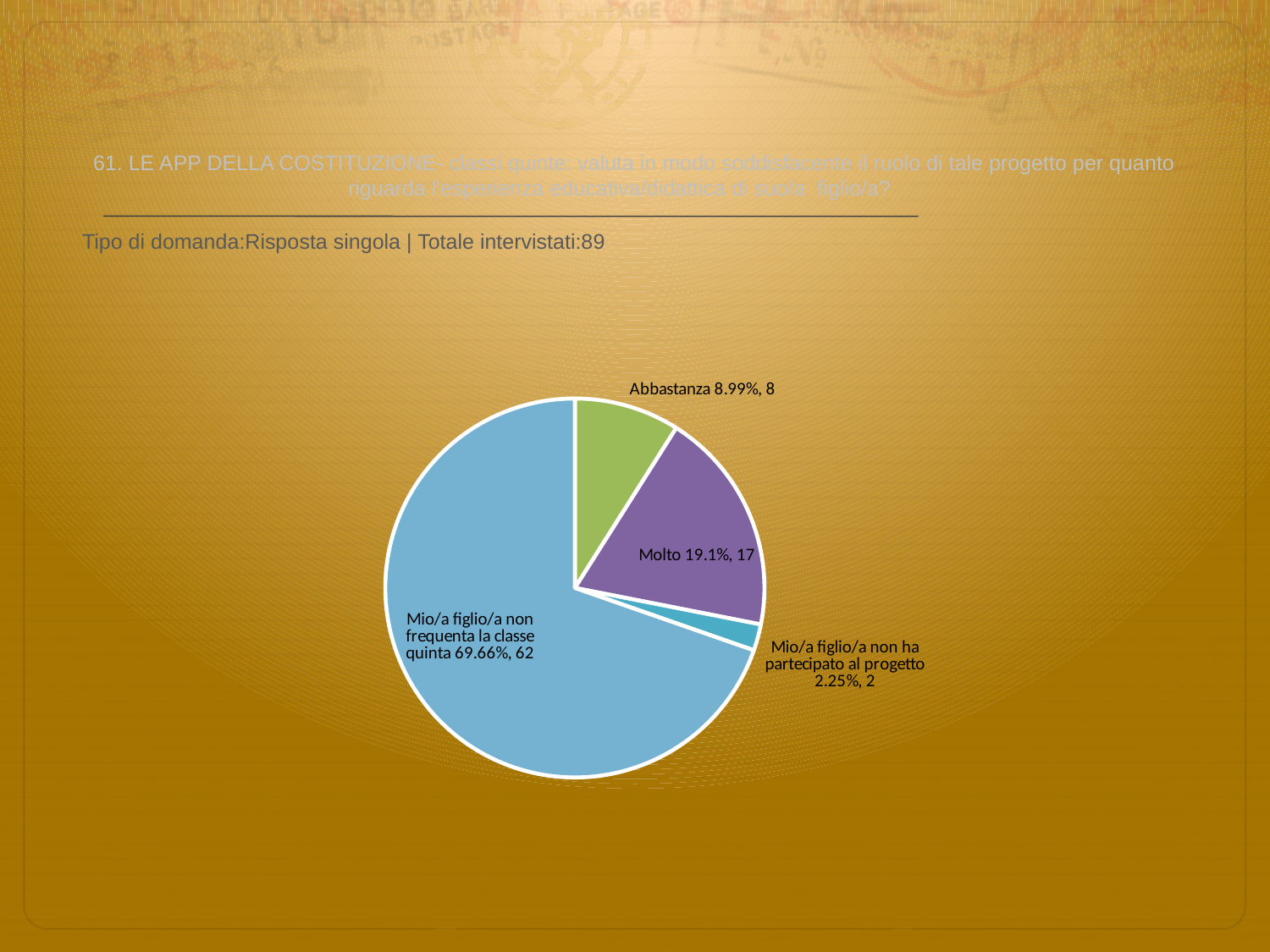
What is the total number of respondents stated on the slide? 89 Which has more respondents, 'Molto' or 'Abbastanza'? Molto What percentage of the pie is the 'Abbastanza' slice? 8.99% What kind of chart is shown on the slide? pie chart How many slices does the pie chart have? 4 How many respondents answered 'Abbastanza'? 8 What percentage of the pie is the 'Mio/a figlio/a non frequenta la classe quinta' slice? 69.66% How many respondents answered 'Mio/a figlio/a non ha partecipato al progetto'? 2 What percentage of the pie is the 'Molto' slice? 19.1% Which category has the smallest slice of the pie? Mio/a figlio/a non ha partecipato al progetto What is the difference in respondent count between 'Molto' and 'Abbastanza'? 9 Which category has the largest slice of the pie? Mio/a figlio/a non frequenta la classe quinta